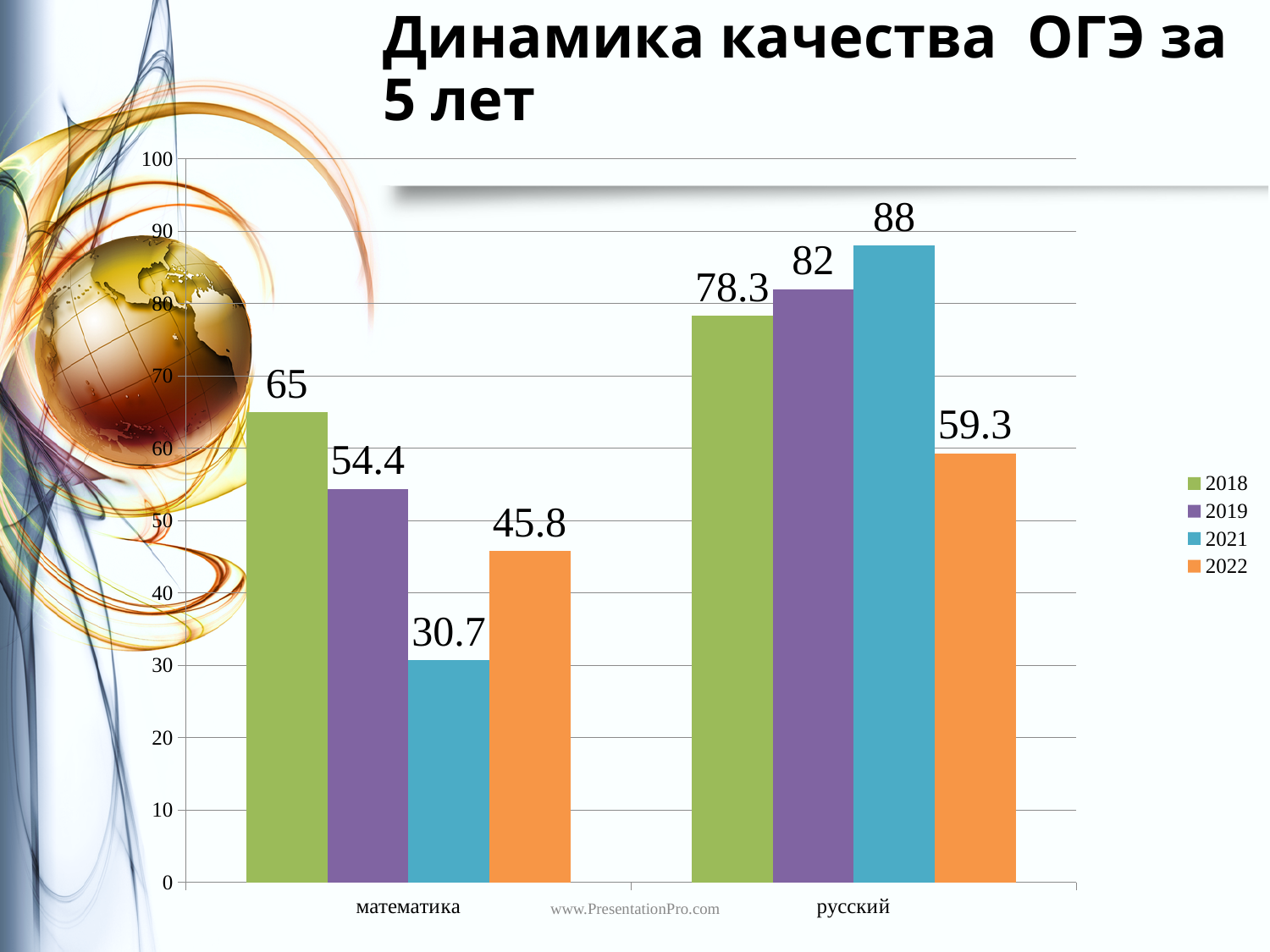
What kind of chart is shown on the slide? bar chart How many series does the legend list? 4 What is the value for математика in 2021? 30.7 What is the title of the slide? Динамика качества ОГЭ за 5 лет Which year has the highest value for русский? 2021 What is the value for русский in 2021? 88 What is the value for математика in 2018? 65 Which is larger: the 2022 value for математика or the 2022 value for русский? русский What is the difference between the 2019 values for русский and математика? 27.6 Which year has the lowest value for математика? 2021 How many categories are shown on the x axis? 2 What is the value for русский in 2022? 59.3